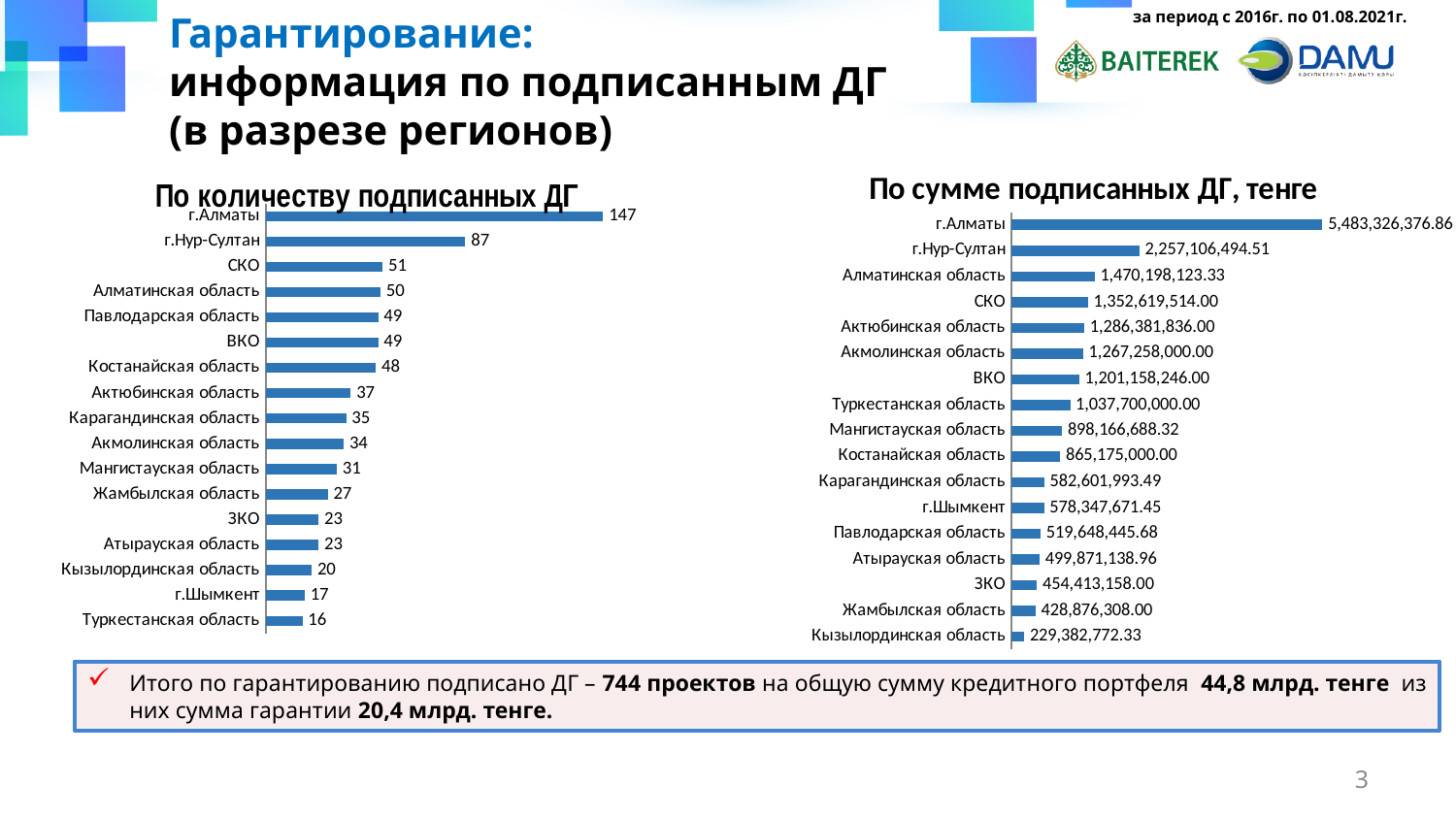
In the chart 'По количеству подписанных ДГ', what is the value for Костанайская область? 48 In the chart 'По сумме подписанных ДГ, тенге', which region has the highest value? г.Алматы In the chart 'По сумме подписанных ДГ, тенге', what is the value for СКО? 1,352,619,514.00 In the chart 'По количеству подписанных ДГ', which is larger: Актюбинская область or Карагандинская область? Актюбинская область In the chart 'По сумме подписанных ДГ, тенге', which is larger: Мангистауская область or Костанайская область? Мангистауская область In the chart 'По сумме подписанных ДГ, тенге', what is the value for Туркестанская область? 1,037,700,000.00 What type of chart is 'По сумме подписанных ДГ, тенге'? Bar chart In the chart 'По количеству подписанных ДГ', what is the difference between г.Алматы and г.Нур-Султан? 60 In the chart 'По количеству подписанных ДГ', how many regions are shown? 17 In the chart 'По сумме подписанных ДГ, тенге', what is the value for Кызылординская область? 229,382,772.33 In the chart 'По количеству подписанных ДГ', which region has the lowest value? Туркестанская область In the chart 'По количеству подписанных ДГ', what is the value for г.Нур-Султан? 87